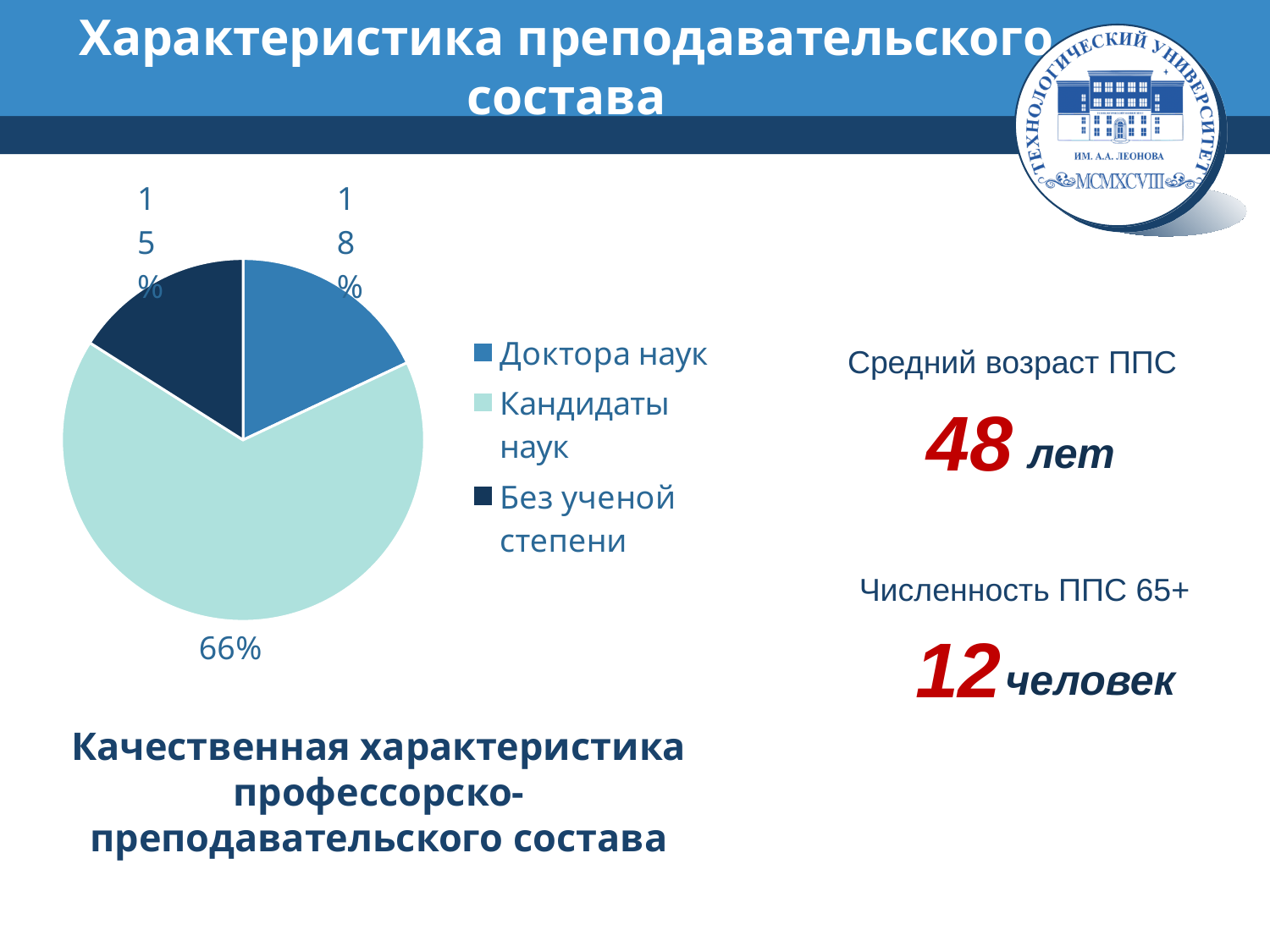
What share of the pie does "Доктора наук" have? 18% How many entries does the legend list? 3 Which category has the largest slice of the pie? Кандидаты наук What is the difference in percentage points between "Кандидаты наук" and "Доктора наук"? 48 What kind of chart is shown on the slide? Pie chart Which category has the smallest slice of the pie? Без ученой степени Which is larger, the share for "Доктора наук" or the share for "Без ученой степени"? Доктора наук What is the caption printed below the pie chart? Качественная характеристика профессорско-преподавательского состава Which legend entry is shown in the darkest blue colour? Без ученой степени What share of the pie does "Без ученой степени" have? 15% What share of the pie does "Кандидаты наук" have? 66% How many slices does the pie chart have? 3